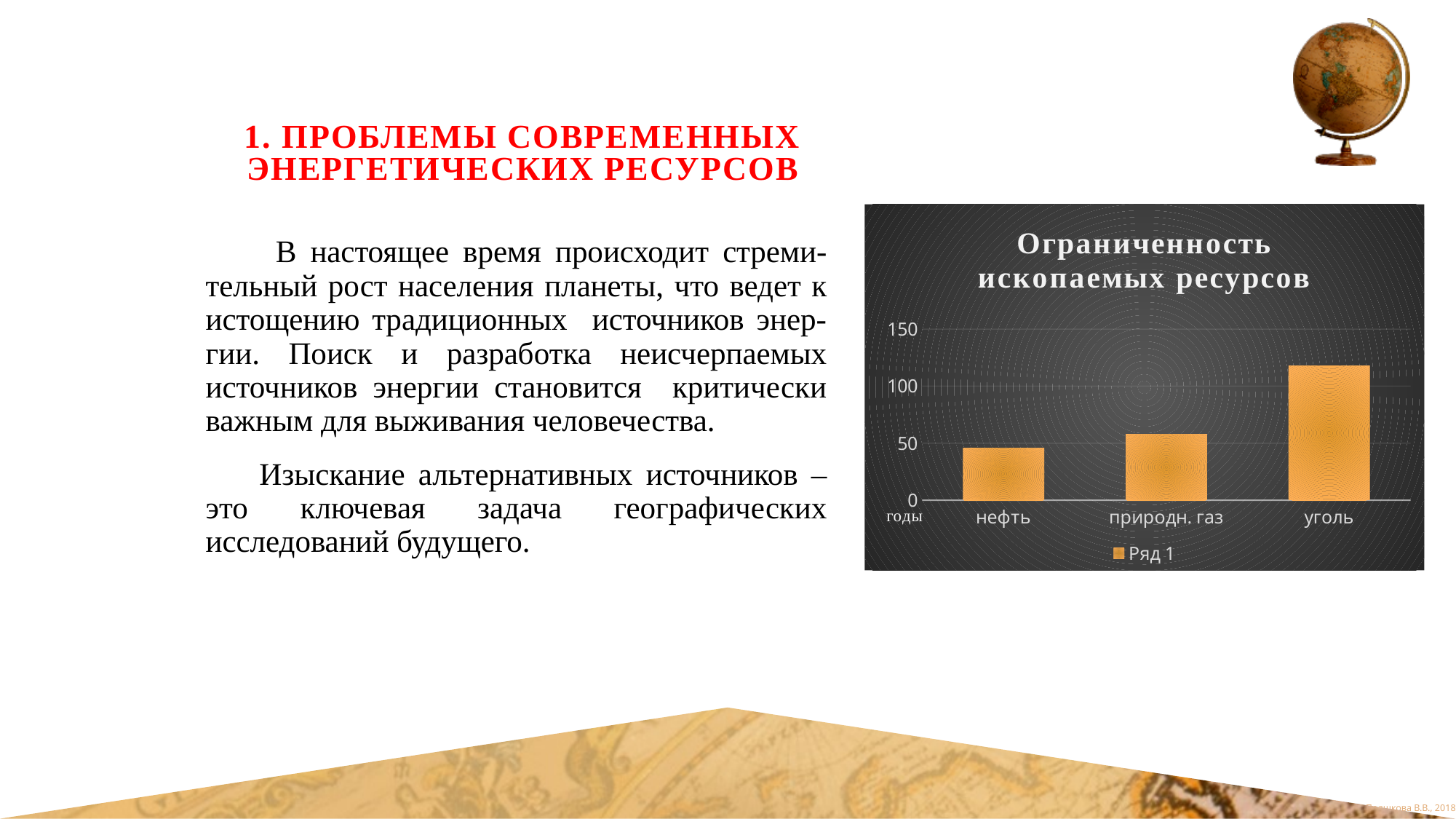
Which category has the highest bar in the chart? уголь Which category has the lowest bar in the chart? нефть What is the title of the chart? Ограниченность ископаемых ресурсов Is the value for уголь greater or less than 100? greater Do the bar values rise or fall from left to right across the x axis? rise Is the value for природн. газ greater or less than 50? greater Is the value for уголь greater or less than 150? less Which is larger, the value for природн. газ or the value for нефть? природн. газ What kind of chart is shown on the slide? bar chart How many series does the chart legend list? 1 What is the name of the series in the chart legend? Ряд 1 How many categories are shown on the x axis of the chart? 3